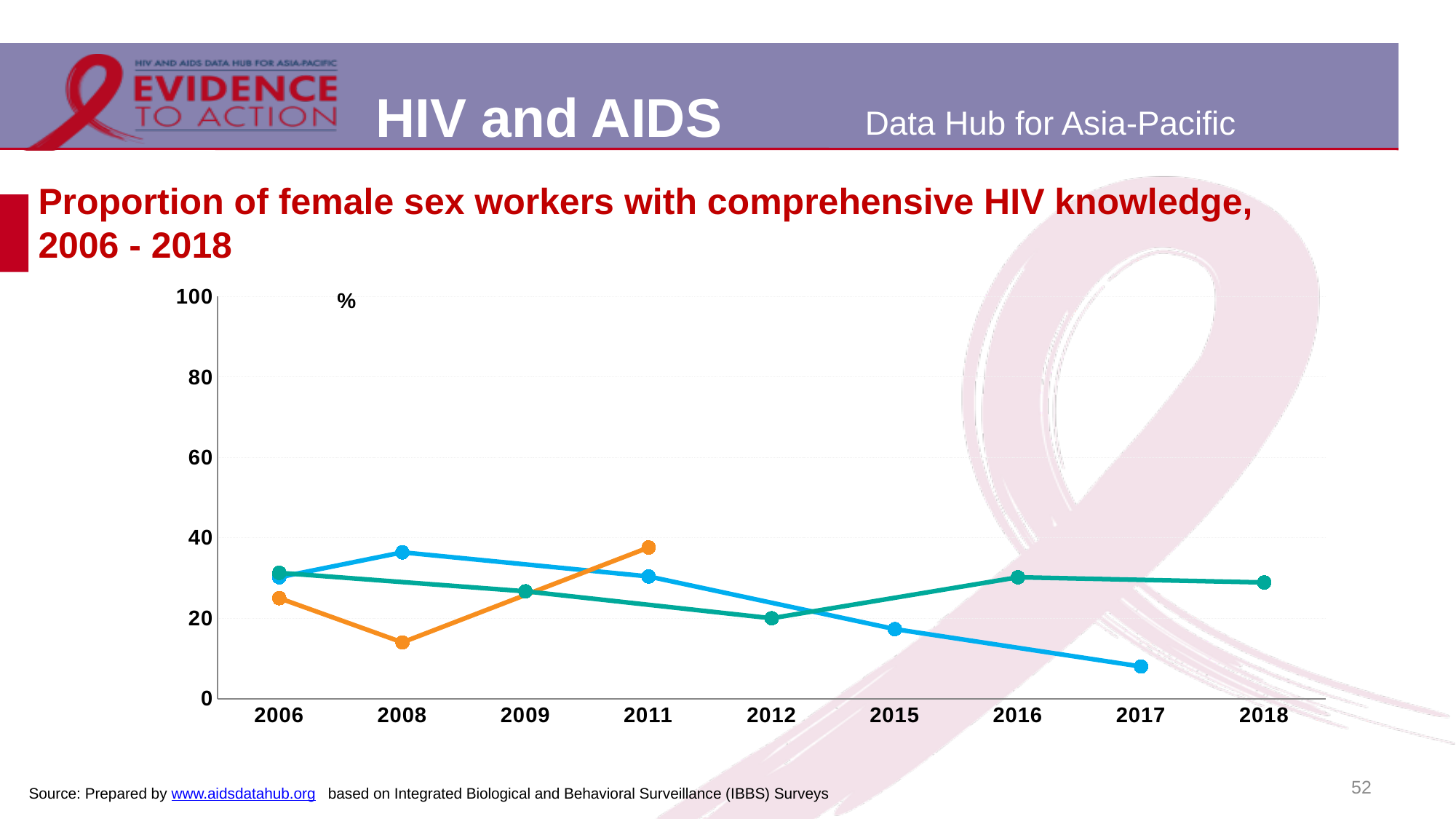
Does the blue line rise or fall between 2008 and 2017? fall Is the value of the blue line in 2008 greater or less than 40? less How many years are labelled on the x axis of the chart? 9 In which year does the orange line reach its highest value? 2011 Is the value of the green line in 2016 greater or less than 20? greater Is the value of the blue line in 2017 greater or less than 20? less What is the title of the chart on the slide? Proportion of female sex workers with comprehensive HIV knowledge, 2006 - 2018 What kind of chart is shown on the slide? line chart In which year does the blue line reach its lowest value? 2017 Which is larger: the orange line's value in 2011 or its value in 2008? 2011 What unit is shown on the y axis of the chart? %